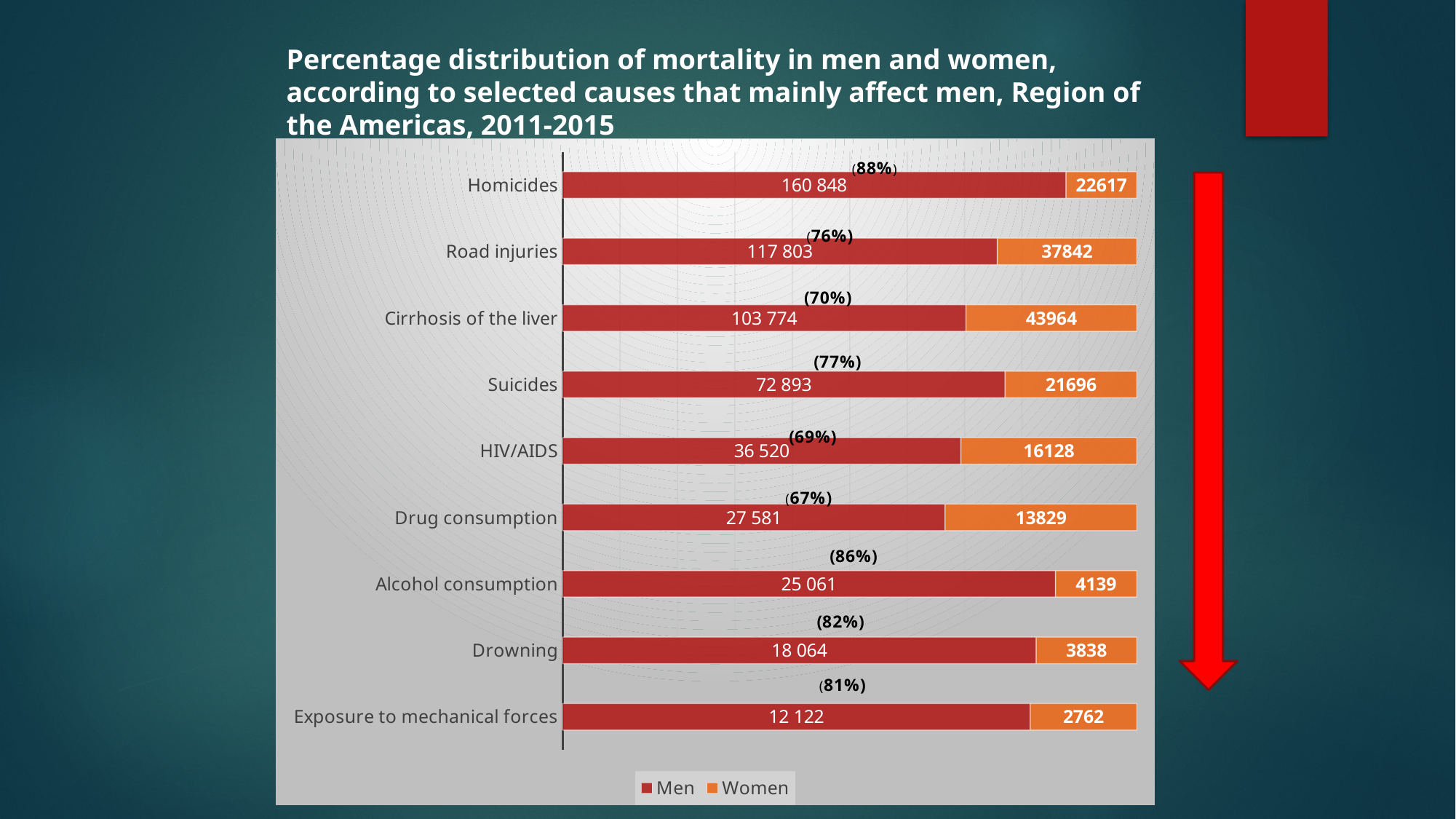
How many series does the legend list? 2 What is the Women value for Cirrhosis of the liver? 43964 Which cause has the lowest Women value? Exposure to mechanical forces What percentage is shown in parentheses for Alcohol consumption? 86% Which cause has the highest Men value? Homicides Which is larger, the Women value for Road injuries or the Women value for Suicides? Road injuries Which cause has the highest Women value? Cirrhosis of the liver How many causes are listed on the chart? 9 What is the difference between the Men and Women values for Homicides? 138 231 What is the Men value for Drowning? 18 064 What kind of chart is shown on the slide? Stacked bar chart What is the Men value for Homicides? 160 848